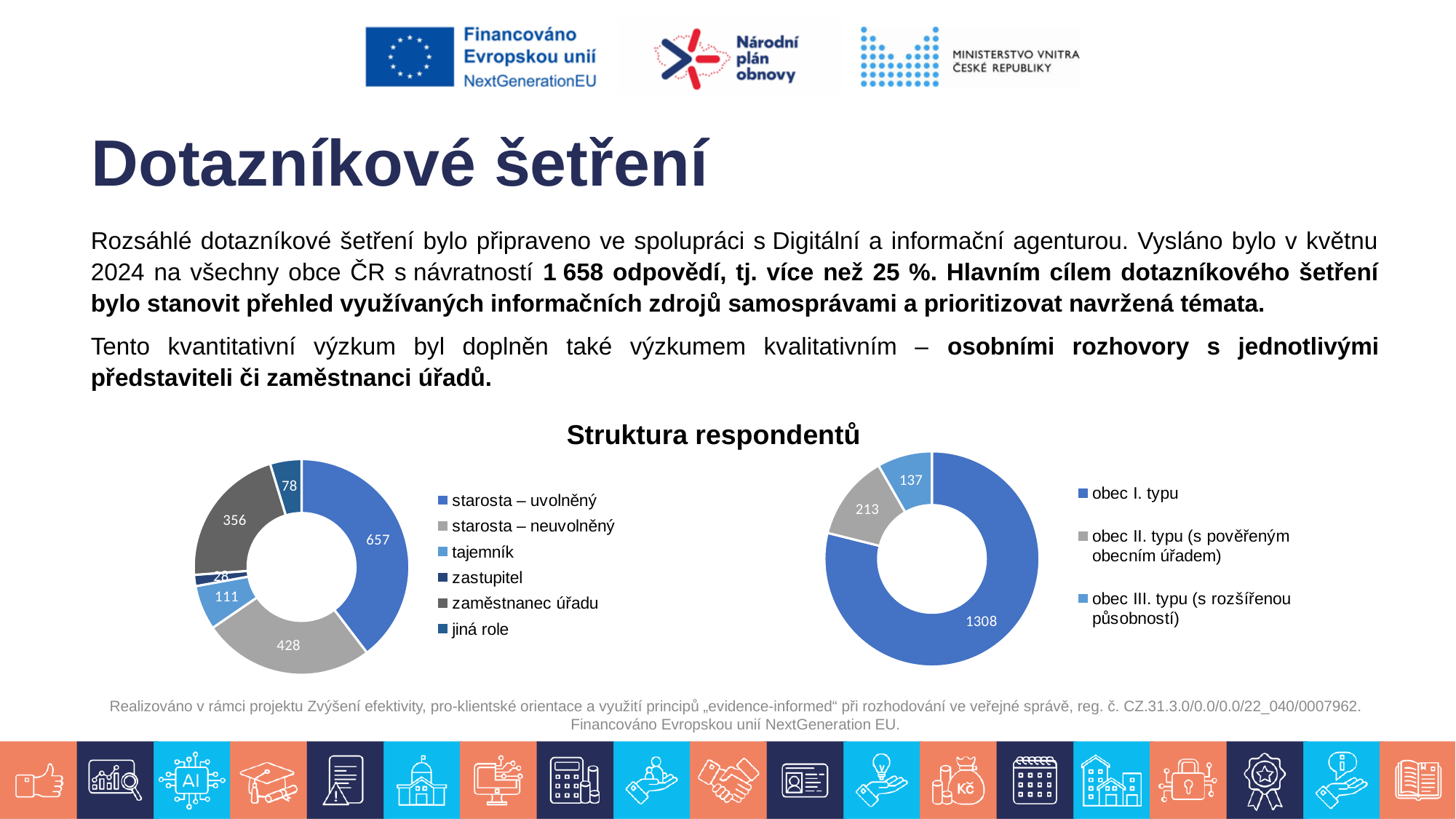
On the right doughnut chart, what is the difference between 'obec II. typu' and 'obec III. typu'? 76 What is the title shown above the two charts? Struktura respondentů On the left doughnut chart, what is the value for 'zaměstnanec úřadu'? 356 How many categories does the legend of the left doughnut chart list? 6 What type of chart is used for the two charts under 'Struktura respondentů'? Doughnut chart On the left doughnut chart, which is larger: 'tajemník' or 'jiná role'? tajemník On the left doughnut chart, what is the difference between 'starosta – uvolněný' and 'starosta – neuvolněný'? 229 On the left doughnut chart, what is the value for 'starosta – uvolněný'? 657 On the right doughnut chart, which category has the largest value? obec I. typu How many categories does the legend of the right doughnut chart list? 3 On the left doughnut chart, which category has the smallest value? zastupitel On the right doughnut chart, what is the value for 'obec II. typu (s pověřeným obecním úřadem)'? 213